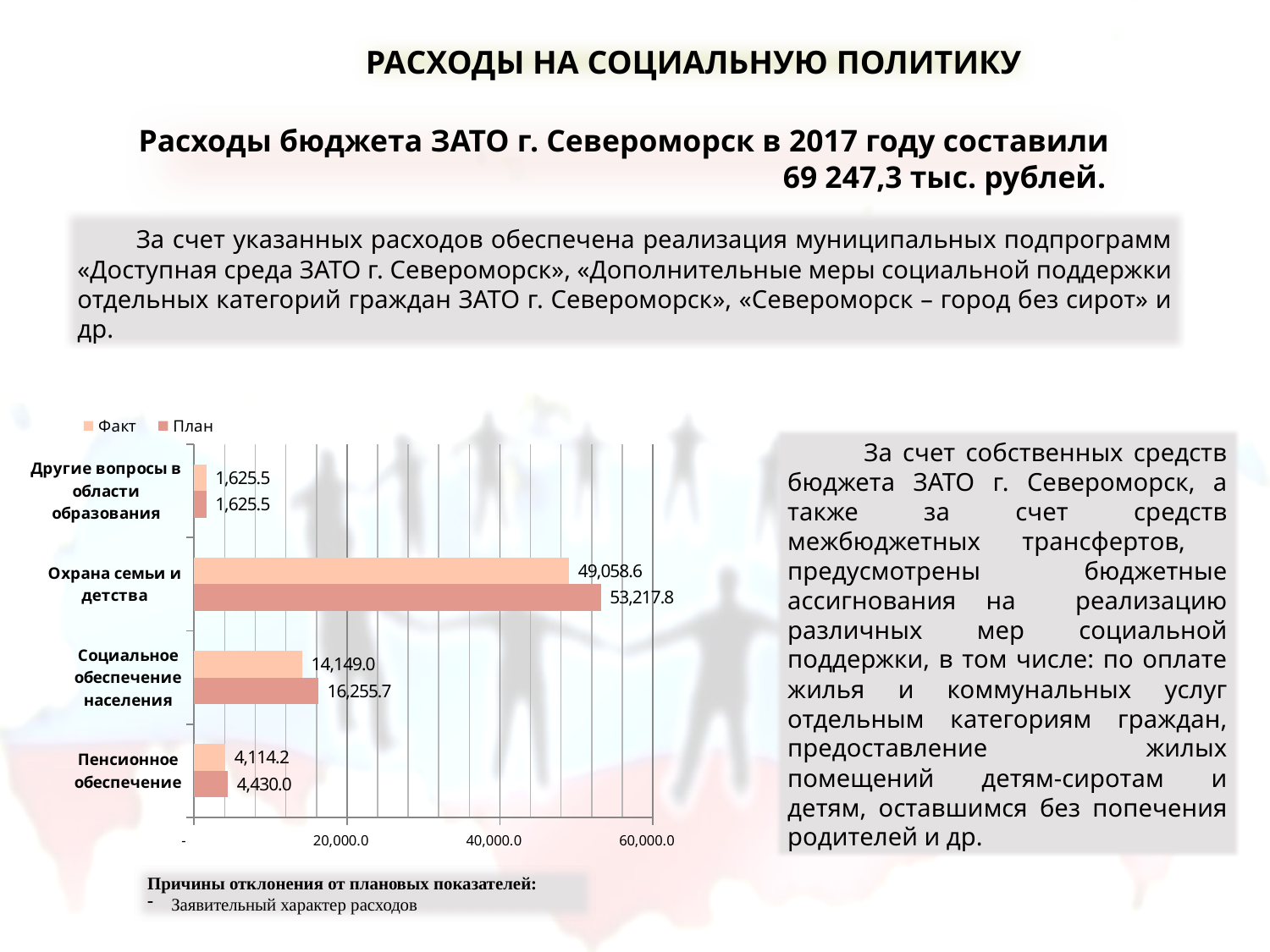
What are the two series named in the chart legend? Факт and План What type of chart is shown on the slide? Bar chart What is the difference between the План and Факт values for Охрана семьи и детства? 4,159.2 Which category has the lowest Факт value? Другие вопросы в области образования What is the Факт value for Охрана семьи и детства? 49,058.6 What is the План value for Пенсионное обеспечение? 4,430.0 How many categories are shown on the chart? 4 How many series does the chart legend list? 2 Which category has the highest План value? Охрана семьи и детства What is the План value for Охрана семьи и детства? 53,217.8 What is the Факт value for Социальное обеспечение населения? 14,149.0 Which is larger for Социальное обеспечение населения: the Факт value or the План value? План